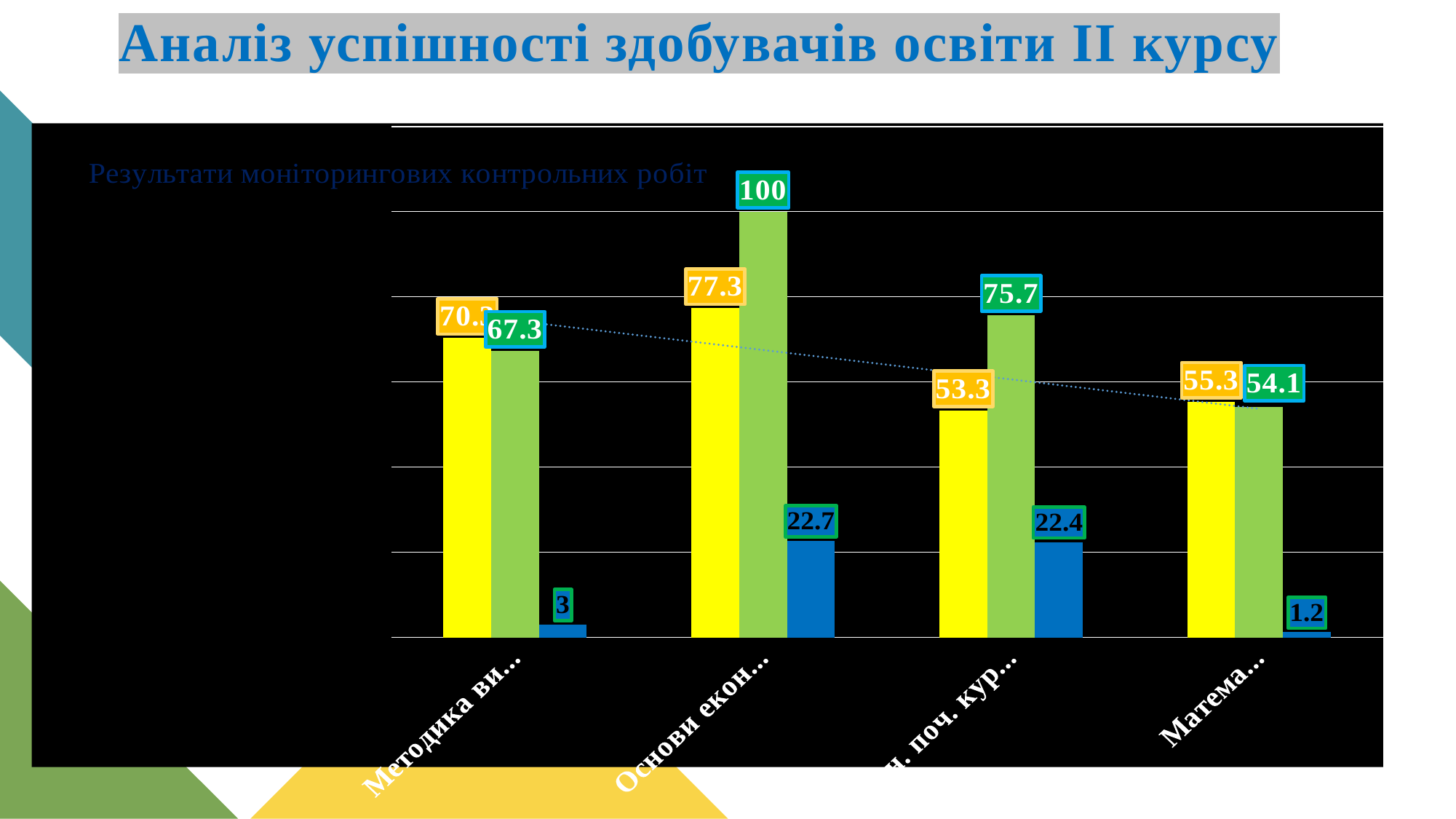
Which category group has the lowest blue bar? Матема... (the fourth group) What kind of chart is shown on the slide? bar chart What is the title of the chart? Результати моніторингових контрольних робіт Which category group has the highest green bar? Основи екон... (the second group) How many bars are there in each category group? 3 What is the value of the yellow bar in the fourth category group (Матема...)? 55.3 How many category groups are plotted along the x axis? 4 What is the difference between the green bar and the yellow bar in the second category group (Основи екон...)? 22.7 What is the value of the green bar in the second category group (Основи екон...)? 100 What is the value of the blue bar in the second category group (Основи екон...)? 22.7 What is the value of the green bar in the third category group? 75.7 In the third category group, which is larger: the yellow bar or the green bar? the green bar